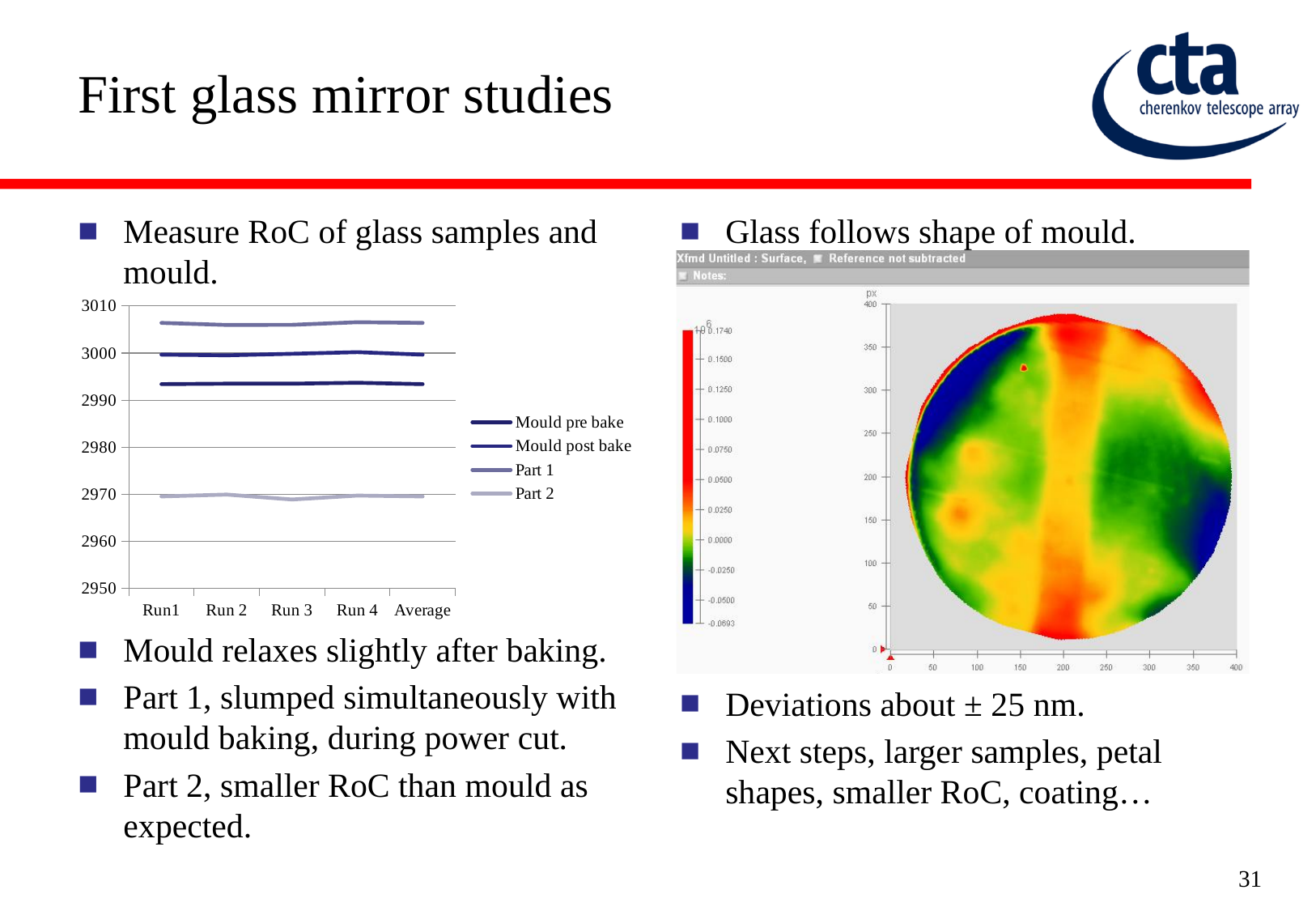
Is the value for Part 1 at Average greater or less than 3000? greater Is the value for Part 2 at Run1 greater or less than 2960? greater Which series in the line chart has the highest values? Part 1 Which series in the line chart has the lowest values? Part 2 What are the category labels on the x axis of the line chart? Run1, Run 2, Run 3, Run 4, Average How many series does the legend of the line chart list? 4 At Run 4, which is larger in the line chart: Part 1 or Part 2? Part 1 Is the value for Part 1 at Run 2 greater or less than 3010? less What kind of chart is shown on the left of the slide? line chart Do the values for Part 2 rise, fall, or stay roughly flat from Run1 to Average? roughly flat How many categories are shown along the x axis of the line chart? 5